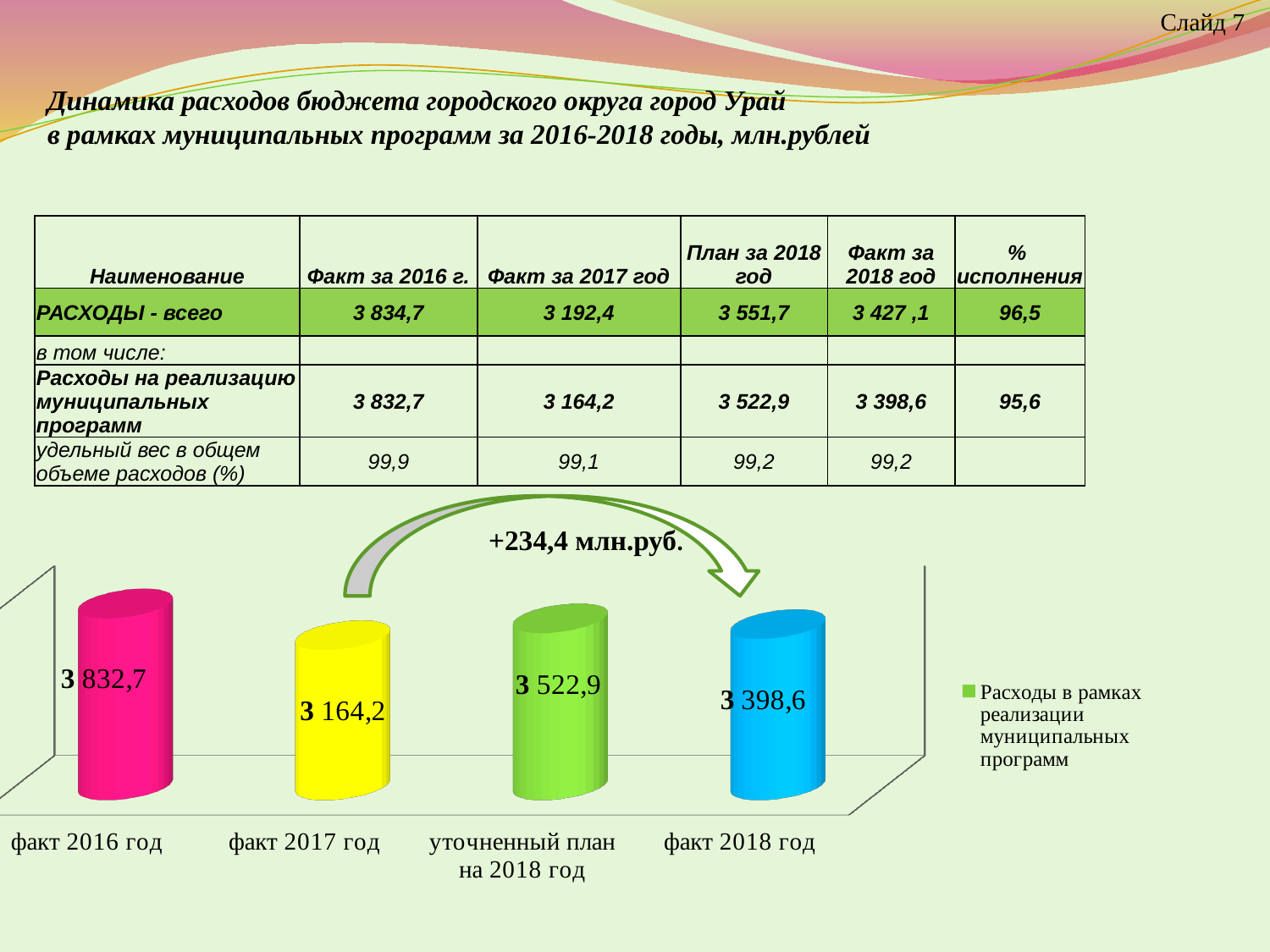
Which category has the highest value in the chart? факт 2016 год What is the value shown for факт 2018 год in the chart? 3 398,6 What is the value shown for факт 2017 год in the chart? 3 164,2 What is the difference between the values for факт 2018 год and факт 2017 год? 234,4 What is the value shown for факт 2016 год in the chart? 3 832,7 Which category has the lowest value in the chart? факт 2017 год What is the value shown for уточненный план на 2018 год in the chart? 3 522,9 What is the difference between the values for факт 2016 год and факт 2017 год? 668,5 Which is larger: the value for уточненный план на 2018 год or the value for факт 2018 год? уточненный план на 2018 год What kind of chart is shown on the slide? bar chart How many categories are shown in the chart? 4 How many series does the chart legend list? 1